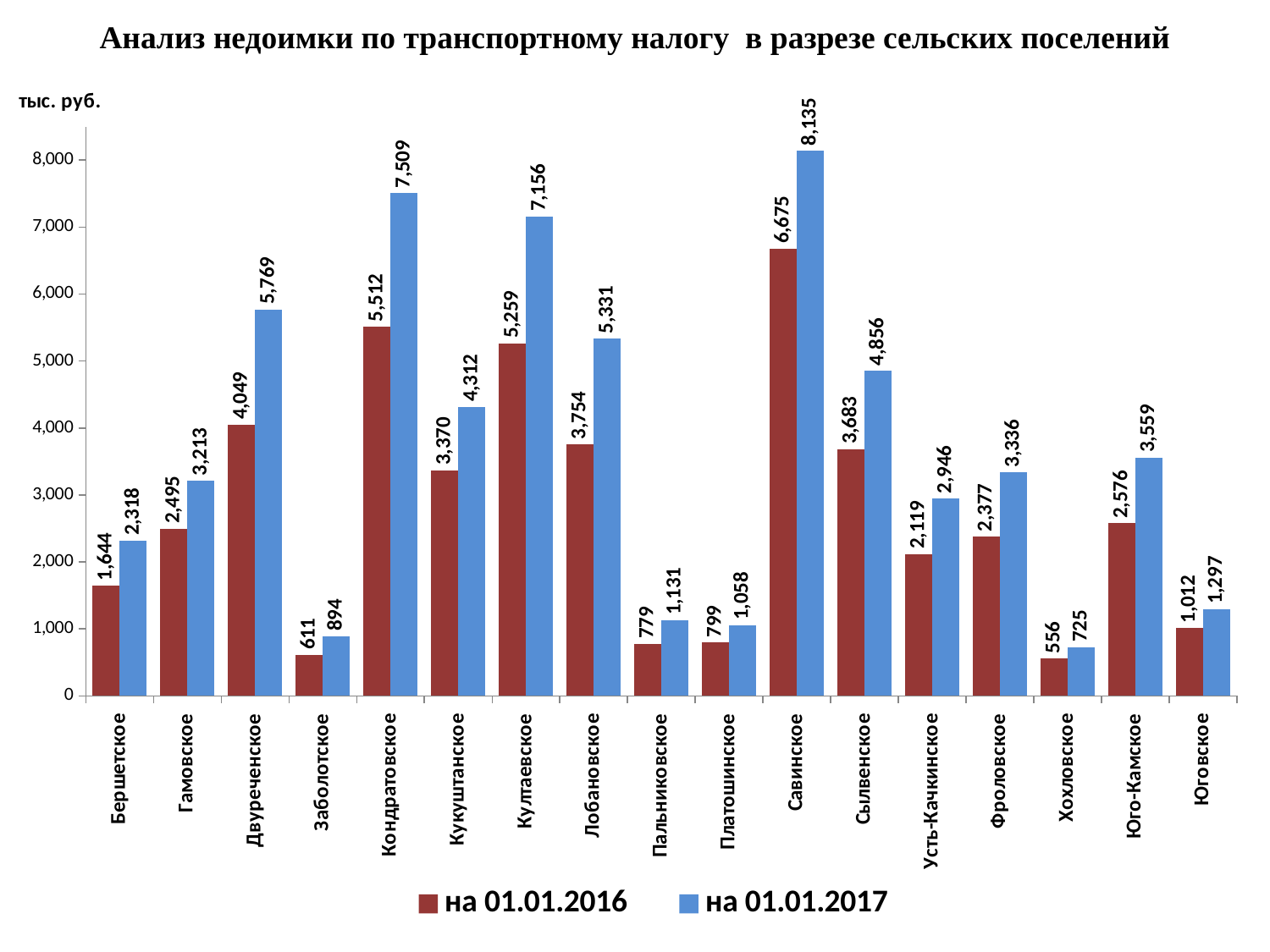
Which is larger for Лобановское: the value for на 01.01.2016 or на 01.01.2017? на 01.01.2017 What unit is indicated above the vertical axis? тыс. руб. Which settlement has the lowest value for на 01.01.2016? Хохловское What is the value for Кондратовское for на 01.01.2016? 5,512 Which settlement has the highest value for на 01.01.2017? Савинское What is the difference between the на 01.01.2017 and на 01.01.2016 values for Савинское? 1,460 How many settlements (categories) are shown on the x axis? 17 What type of chart is shown on the slide? Bar chart What is the value for Савинское for на 01.01.2017? 8,135 How many series does the legend list? 2 What is the value for Хохловское for на 01.01.2017? 725 What is the difference between the на 01.01.2017 and на 01.01.2016 values for Кондратовское? 1,997